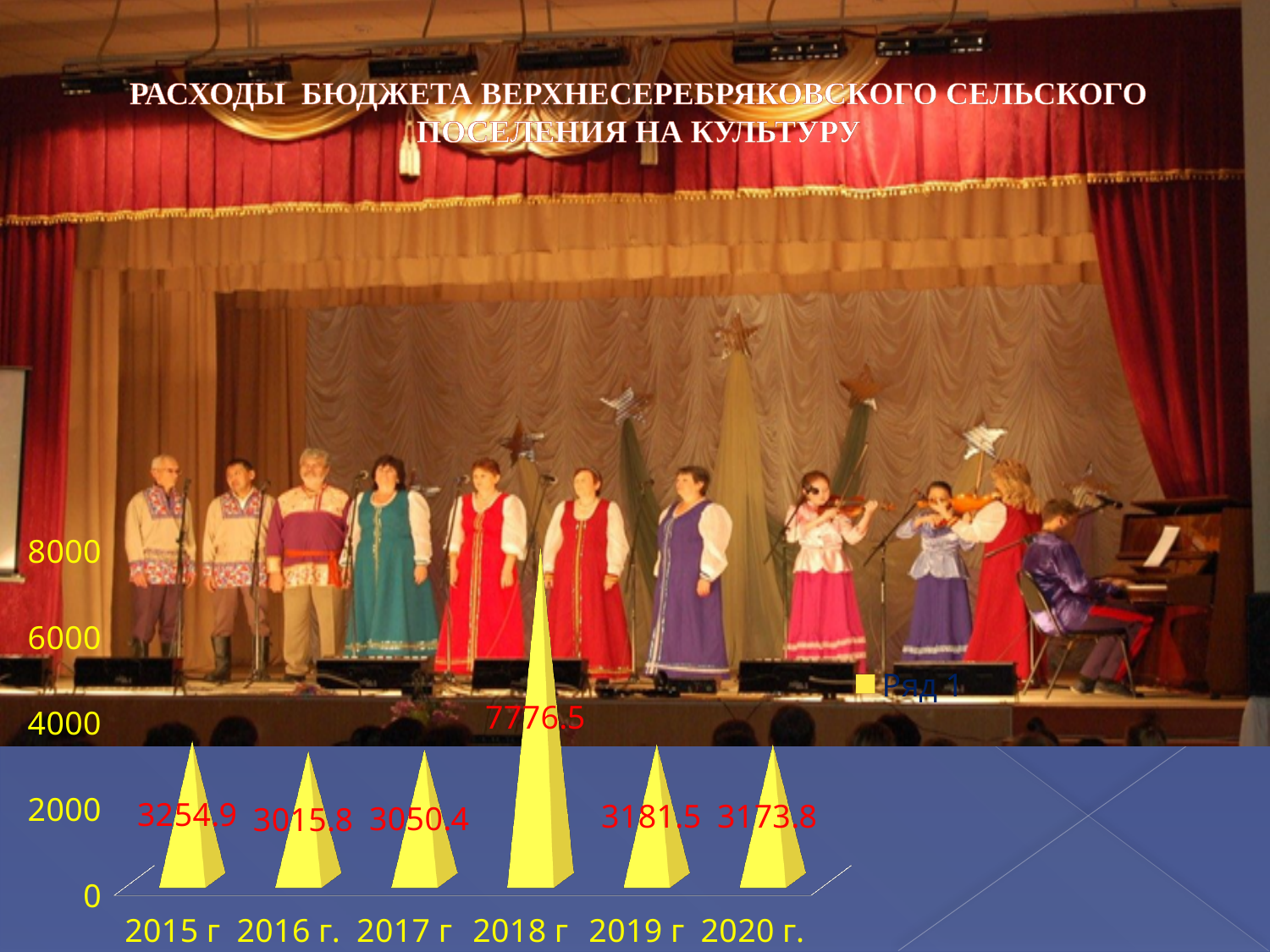
How many series does the legend list? 1 What is the value for 2015 г? 3254.9 What is the difference between the values for 2015 г and 2016 г.? 239.1 Which year has the lowest value? 2016 г. Which year has the highest value? 2018 г What is the value for 2020 г.? 3173.8 Which is larger, the value for 2019 г or the value for 2017 г? 2019 г How many years are shown on the x axis? 6 What kind of chart is shown on the slide? bar chart Is the value for 2018 г greater or less than 6000? greater What is the value for 2018 г? 7776.5 What is the difference between the values for 2018 г and 2017 г? 4726.1